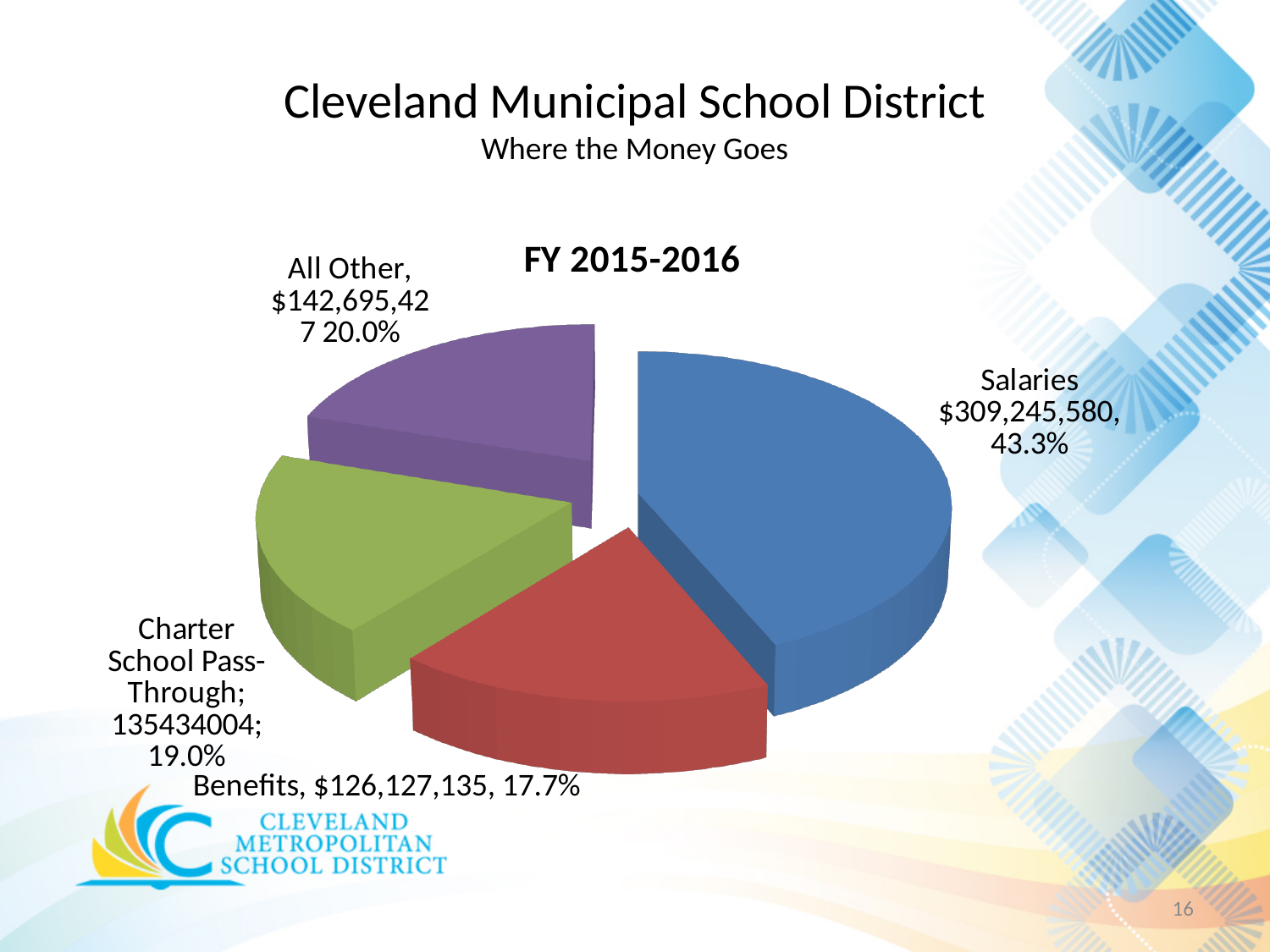
Which category has the smallest slice of the pie? Benefits What value is shown for Charter School Pass-Through? 135434004 What is the dollar value shown for Salaries? $309,245,580 What is the title of the chart? FY 2015-2016 How many slices does the pie chart have? 4 What type of chart is shown on the slide? Pie chart What share of the pie does All Other represent? 20.0% What percentage of the pie is Benefits? 17.7% What colour is the Salaries slice? Blue Which category has the largest slice of the pie? Salaries What is the difference in dollars between Salaries and Benefits? $183,118,445 Which is larger, the share for All Other or the share for Charter School Pass-Through? All Other